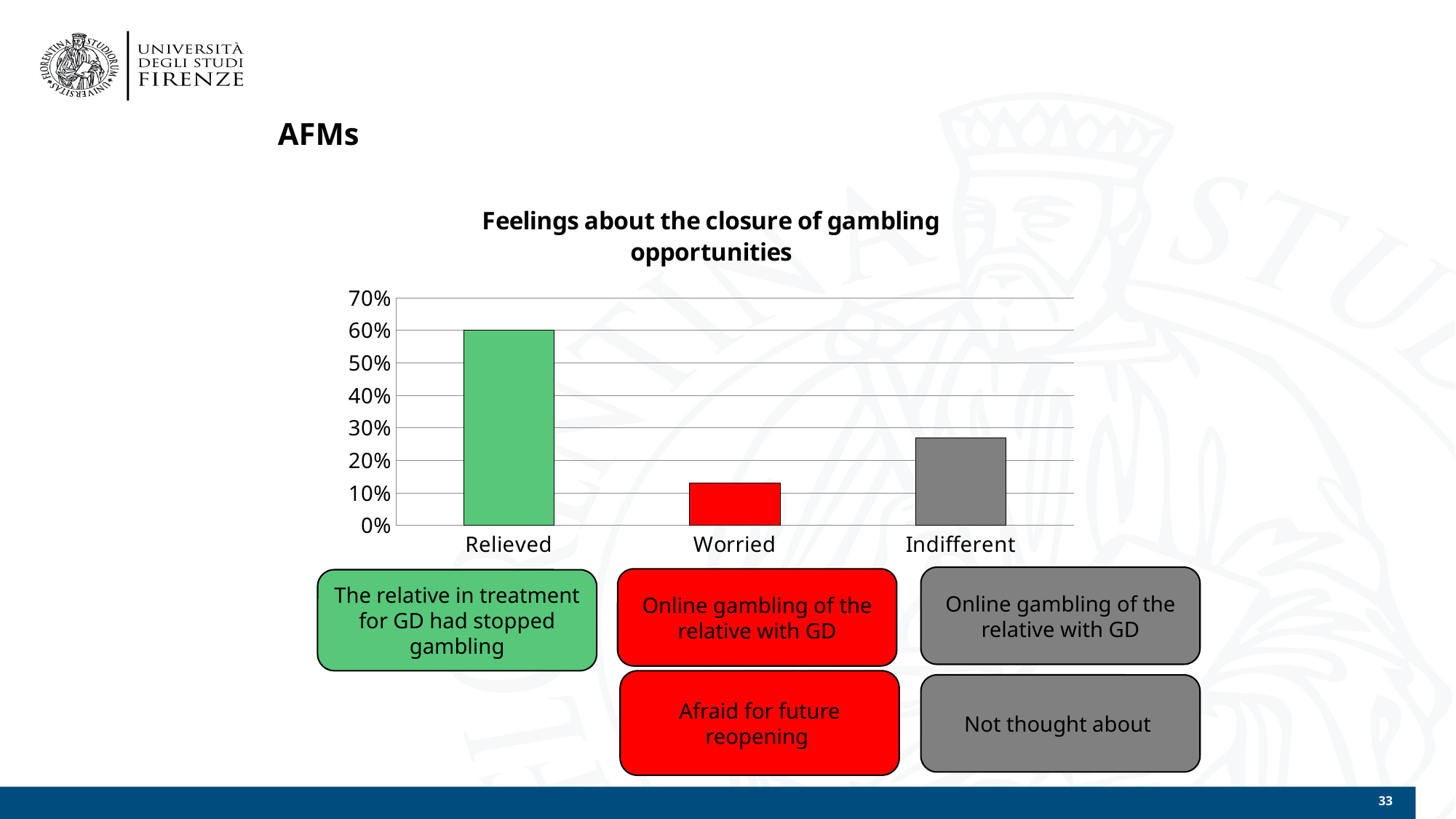
How many categories are shown on the x axis of the chart? 3 What colour is the bar for Worried? red Is the value for Indifferent greater or less than 30%? less Which is larger, the value for Indifferent or the value for Worried? Indifferent Which category has the lowest value in the chart? Worried Which category has the highest value in the chart? Relieved Is the value for Relieved greater or less than 50%? greater Is the value for Indifferent greater or less than 20%? greater What is the title of the chart? Feelings about the closure of gambling opportunities What type of chart is shown on the slide? bar chart What is the value for Relieved? 60%